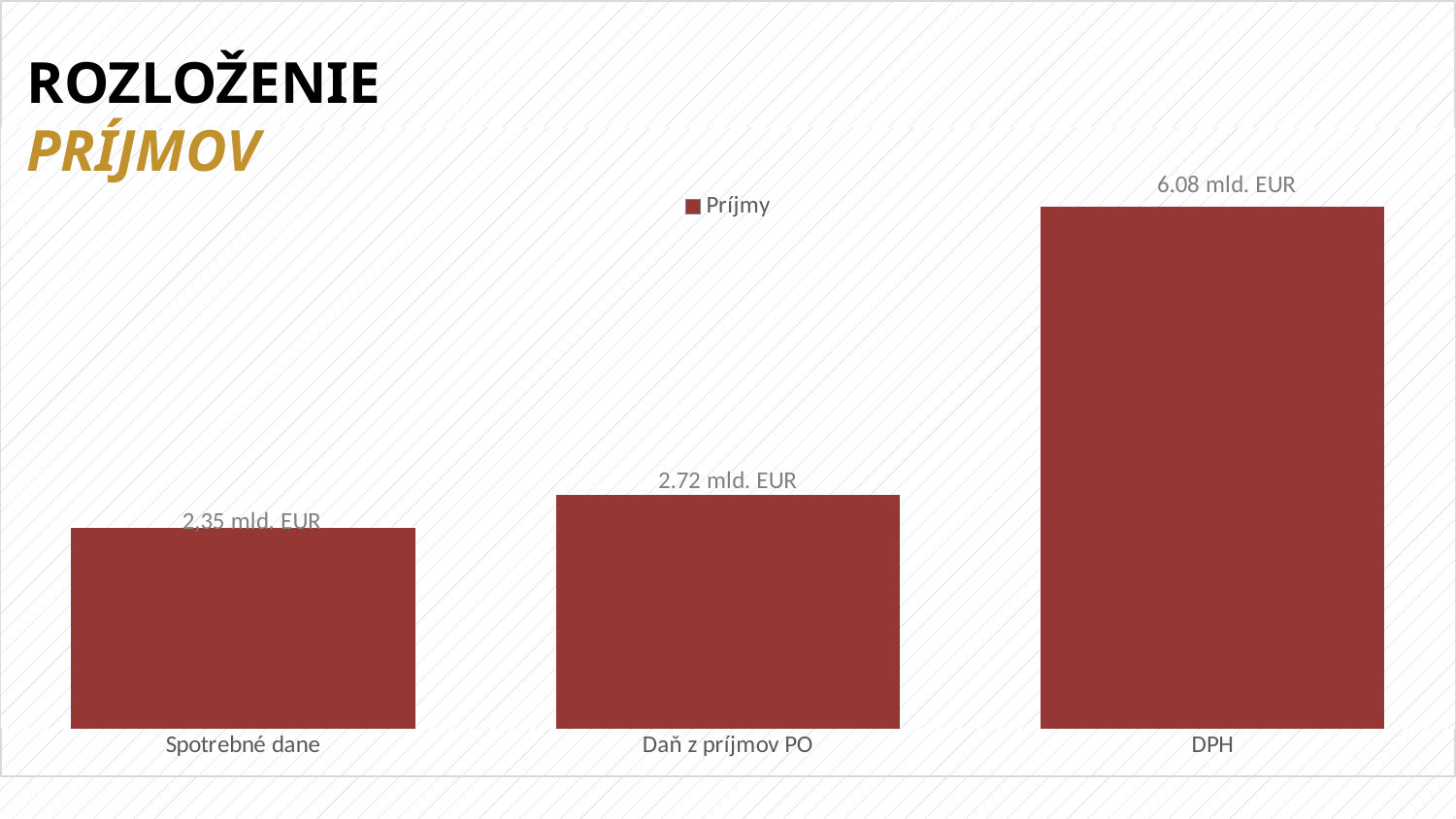
What is the value for DPH? 6.08 mld. EUR What is the value for Daň z príjmov PO? 2.72 mld. EUR What is the name of the series shown in the legend? Príjmy Which is larger, the value for DPH or the value for Spotrebné dane? DPH What kind of chart is shown on the slide? Bar chart Which category has the highest value? DPH Which category has the lowest value? Spotrebné dane What is the difference between the values for Daň z príjmov PO and Spotrebné dane? 0.37 mld. EUR What is the difference between the values for DPH and Daň z príjmov PO? 3.36 mld. EUR How many series does the legend list? 1 What is the value for Spotrebné dane? 2.35 mld. EUR How many categories are shown in the chart? 3